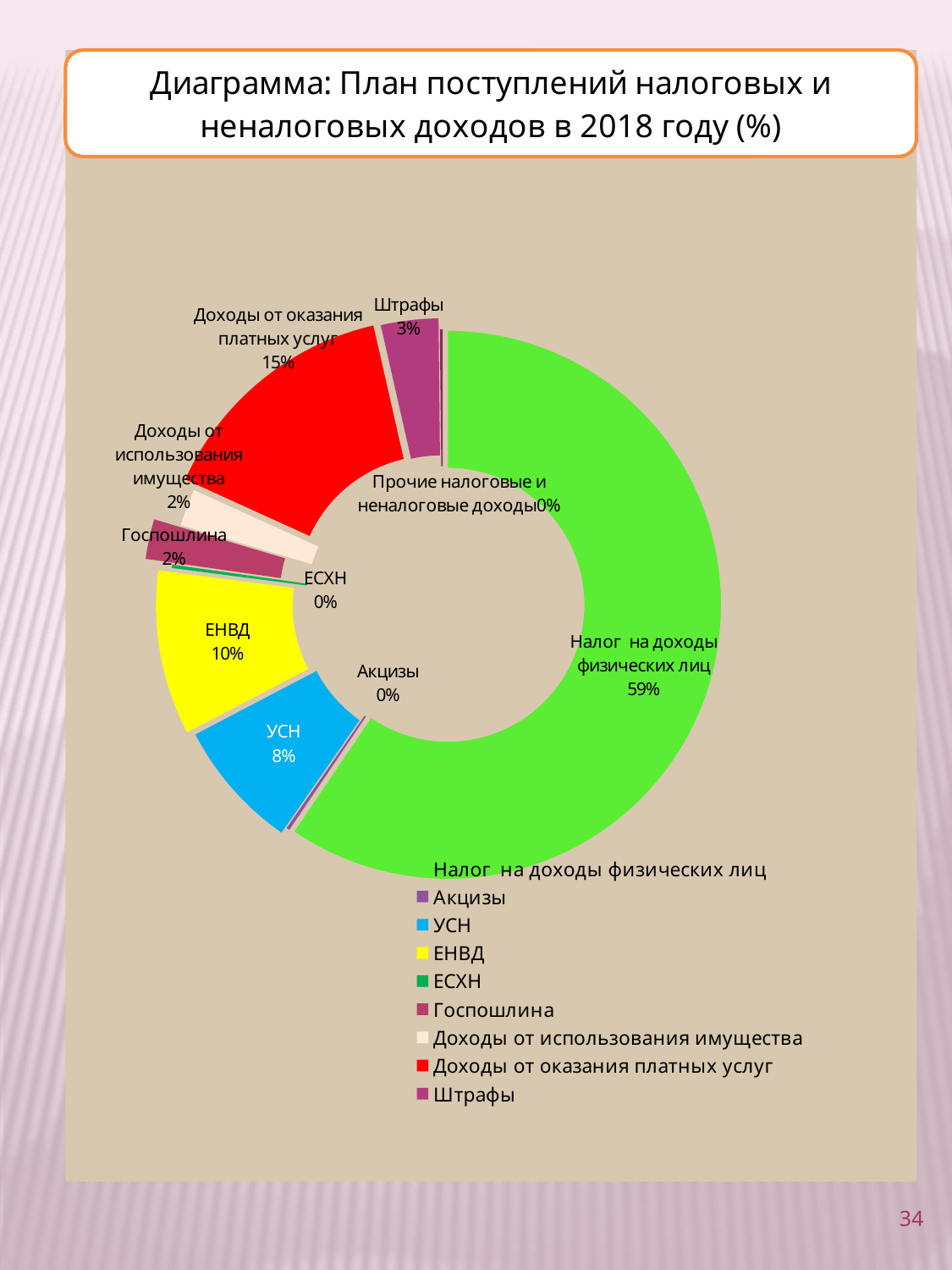
Which category has the largest share in the chart? Налог на доходы физических лиц What percentage is shown for УСН? 8% Which has the larger share, ЕНВД or УСН? ЕНВД What is the difference between the shares of «Налог на доходы физических лиц» and «Доходы от оказания платных услуг»? 44 percentage points What type of chart is shown on the slide? Doughnut (pie) chart What percentage is shown for «Доходы от оказания платных услуг»? 15% What percentage is shown for «Штрафы»? 3% How many entries does the chart legend list? 9 What percentage is shown for ЕНВД? 10% By how many percentage points does «Доходы от оказания платных услуг» exceed ЕНВД? 5 percentage points What share of the plan does «Налог на доходы физических лиц» account for? 59% What percentage is shown for «Госпошлина»? 2%